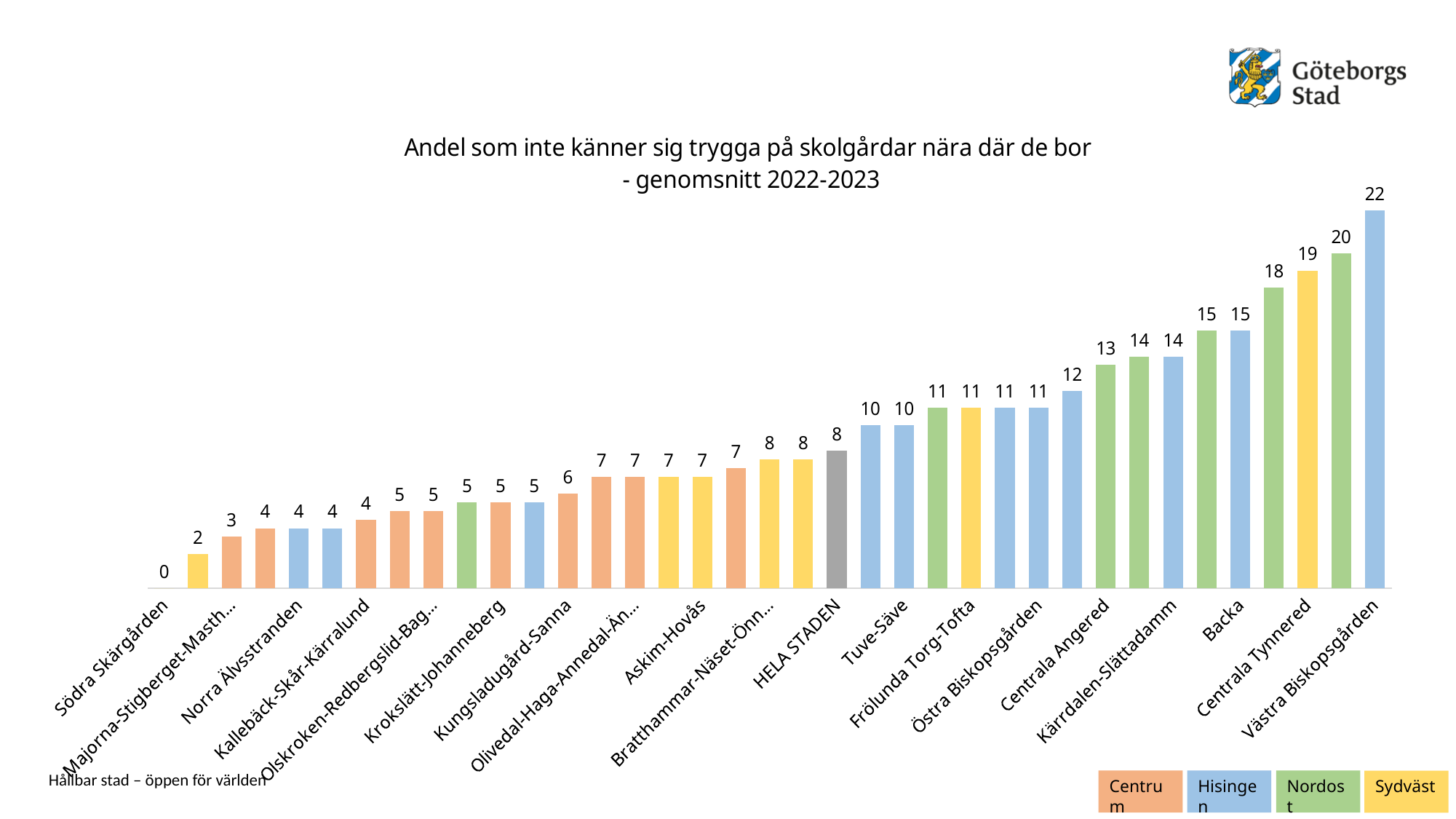
Do the values rise or fall from left to right along the x axis? Rise What is the value for Tuve-Säve? 10 What colour are the bars for Hisingen according to the legend? Blue How many entries does the legend list? 4 Which category has the highest value? Västra Biskopsgården What is the value for Västra Biskopsgården? 22 What kind of chart is shown on the slide? Bar chart What is the difference between the values for Västra Biskopsgården and Centrala Tynnered? 3 What is the value for HELA STADEN? 8 What is the value for Centrala Angered? 13 Which category has the lowest value? Södra Skärgården Which is larger, the value for Backa or the value for Kärrdalen-Slättadamm? Backa